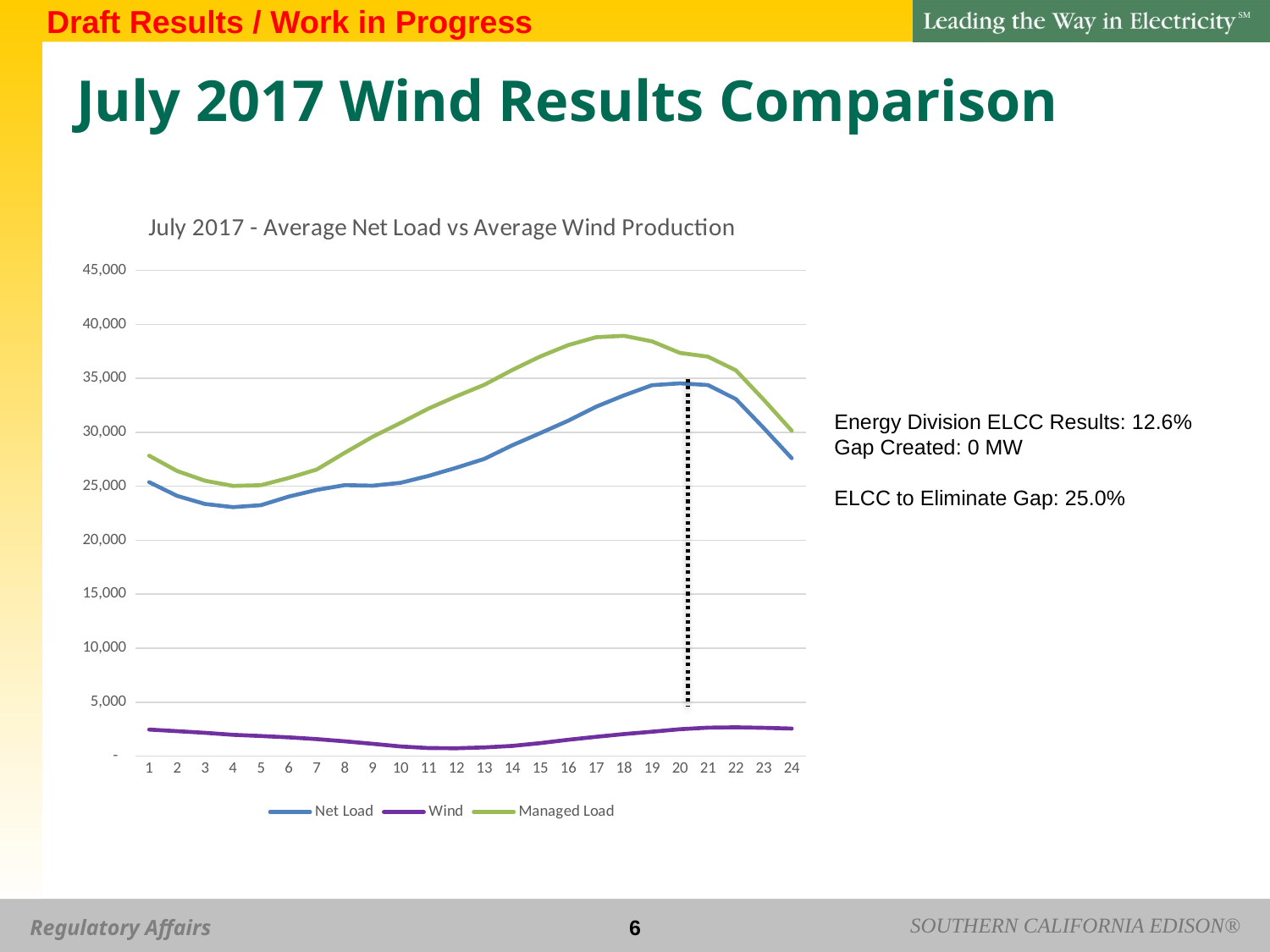
What is the title of the chart? July 2017 - Average Net Load vs Average Wind Production Is the Net Load value at hour 4 greater or less than 25,000? less How many series does the chart legend list? 3 Is the Wind value at hour 12 greater or less than 5,000? less Which series has the lowest values across the chart? Wind Does the Net Load line rise or fall from hour 12 to hour 20? Rise How many hours (points) are plotted along the x axis? 24 Is the Managed Load value at hour 18 greater or less than 35,000? greater Which series has the highest values across the chart? Managed Load At hour 12, which is larger: Managed Load or Net Load? Managed Load Which series is plotted with the purple line? Wind What kind of chart is shown on the slide? Line chart